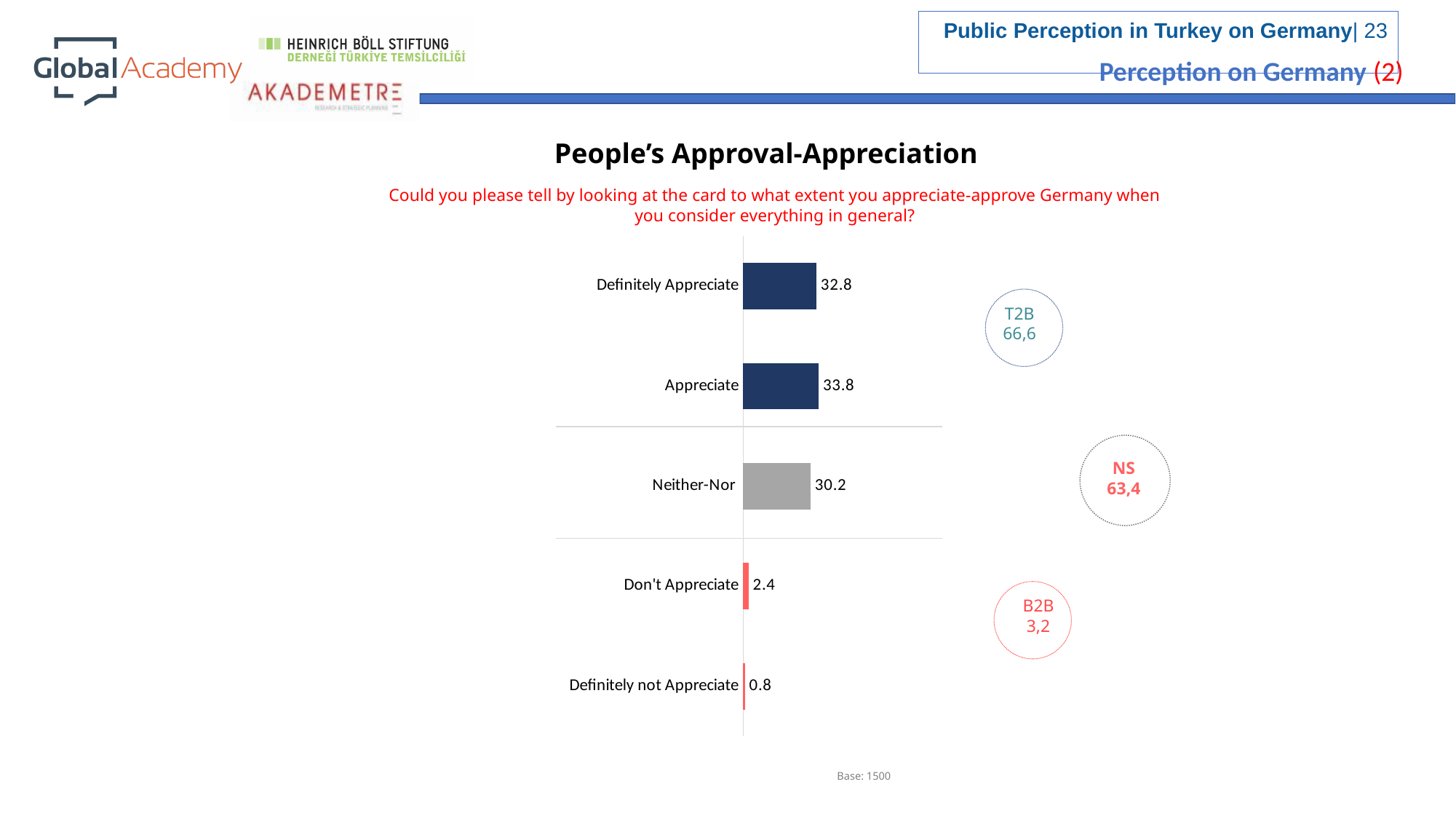
What is the value for Appreciate? 33.8 What is the value for Definitely Appreciate? 32.8 What is the value for Definitely not Appreciate? 0.8 What is the value for Neither-Nor? 30.2 What is the value for Don't Appreciate? 2.4 How many categories are shown in the chart? 5 Which category has the lowest value? Definitely not Appreciate Which is larger, the value for Neither-Nor or the value for Don't Appreciate? Neither-Nor What is the title of the chart? People's Approval-Appreciation What kind of chart is shown on the slide? Bar chart What is the difference between the values for Appreciate and Definitely Appreciate? 1.0 Which category has the highest value? Appreciate